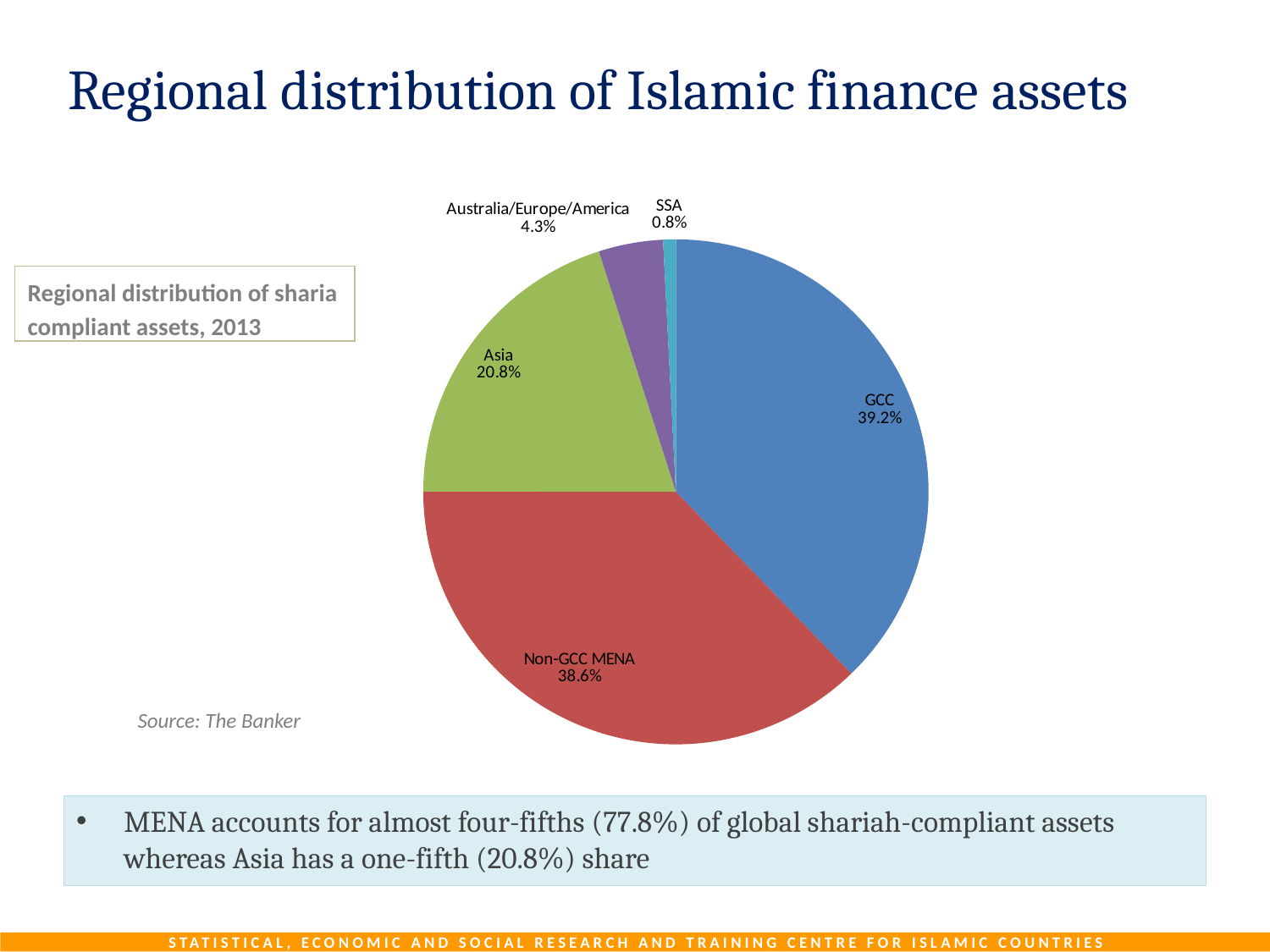
What share of sharia compliant assets does Non-GCC MENA hold? 38.6% What share of sharia compliant assets does GCC hold? 39.2% What share of sharia compliant assets does SSA hold? 0.8% Which has a larger share, Asia or Australia/Europe/America? Asia How many regions are shown in the pie chart? 5 Which region has the largest share of sharia compliant assets? GCC Which region has the smallest share of sharia compliant assets? SSA What kind of chart is shown on the slide? Pie chart What is the difference in share between GCC and Non-GCC MENA? 0.6% What is the difference in share between Asia and Australia/Europe/America? 16.5% What share of sharia compliant assets does Australia/Europe/America hold? 4.3% What share of sharia compliant assets does Asia hold? 20.8%